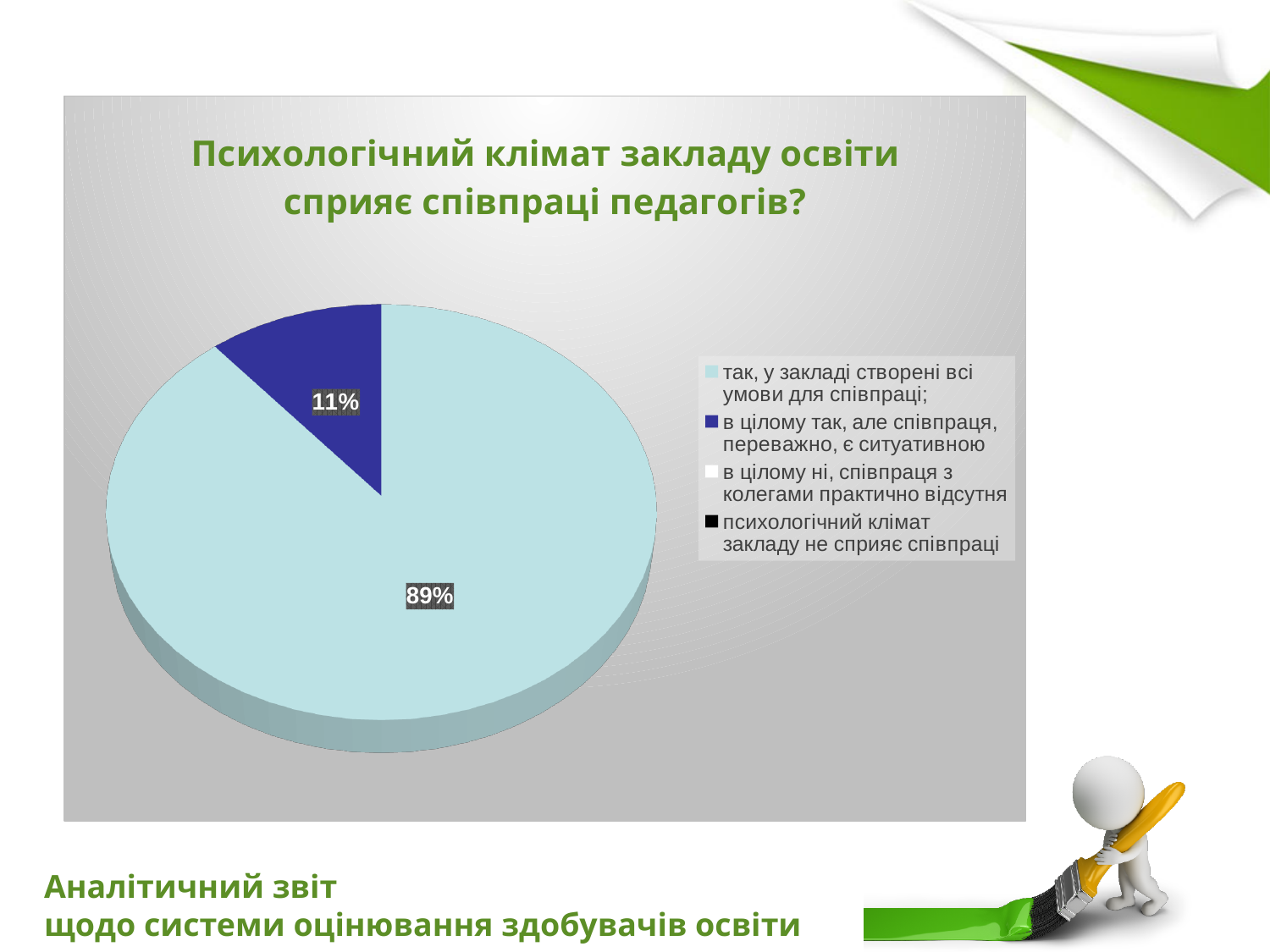
How many slices of the pie are labelled with a percentage? 2 Which slice is larger: "так, у закладі створені всі умови для співпраці;" or "в цілому так, але співпраця, переважно, є ситуативною"? так, у закладі створені всі умови для співпраці; Which category has the largest slice of the pie? так, у закладі створені всі умови для співпраці; What is the difference in percentage points between the 89% slice and the 11% slice? 78 percentage points What share of the pie is labelled for the category "в цілому так, але співпраця, переважно, є ситуативною"? 11% What share of the pie is labelled for the category "так, у закладі створені всі умови для співпраці;"? 89% What is the title of the chart? Психологічний клімат закладу освіти сприяє співпраці педагогів? What colour is the slice representing 11%? dark blue Is the share for "в цілому так, але співпраця, переважно, є ситуативною" greater or less than 50%? less What kind of chart is shown on the slide? pie chart How many entries does the legend list? 4